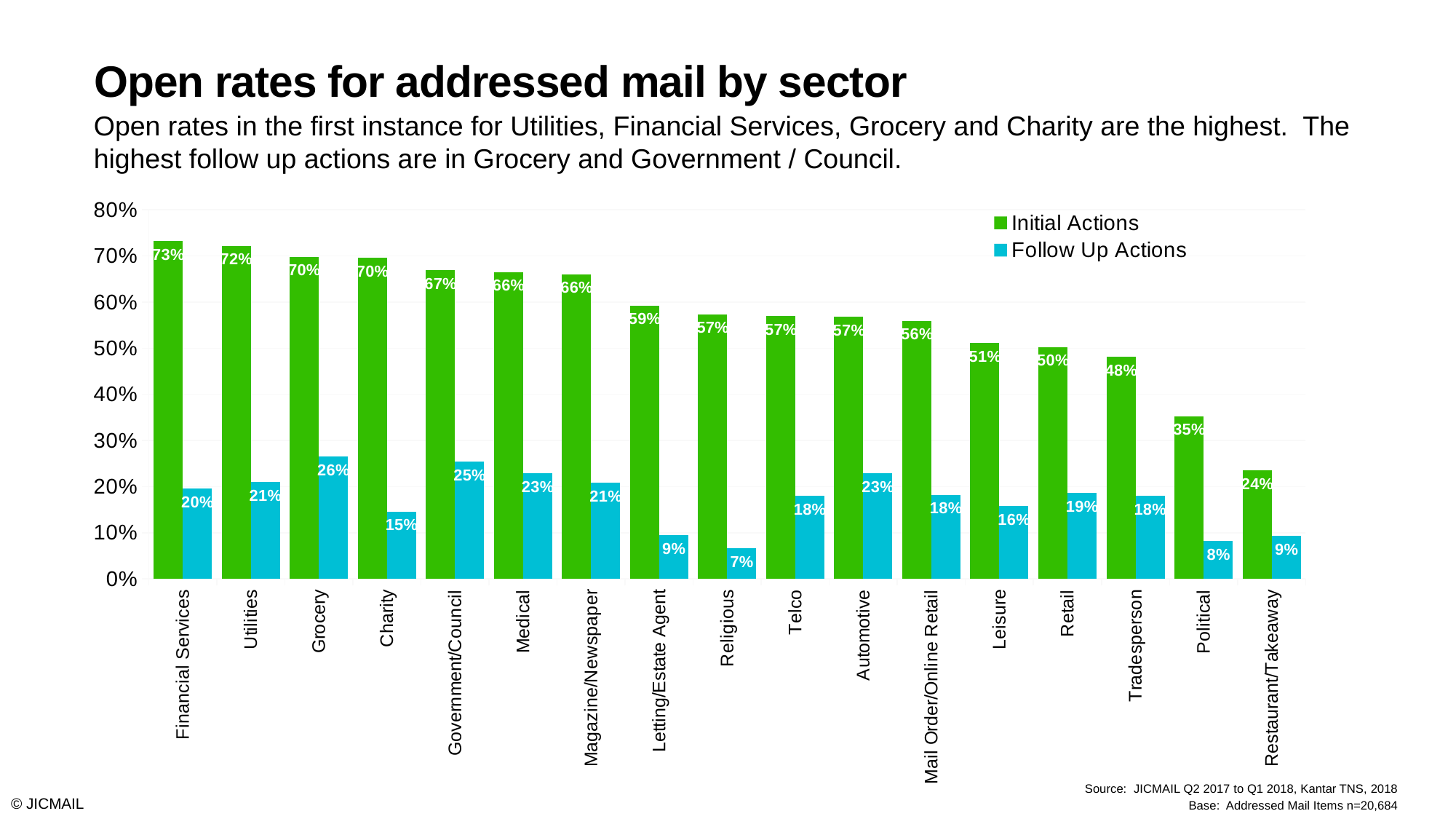
What is the Initial Actions value for Grocery? 70% Is the Initial Actions value for Tradesperson greater or less than 50%? less Which sector has the lowest Follow Up Actions value? Religious What is the difference between the Initial Actions and Follow Up Actions values for Financial Services? 53% What is the Follow Up Actions value for Government/Council? 25% What is the Initial Actions value for Political? 35% Which is larger, the Follow Up Actions value for Charity or for Medical? Medical Which sector has the lowest Initial Actions value? Restaurant/Takeaway What kind of chart is shown on the slide? Bar chart Which sector has the highest Follow Up Actions value? Grocery How many series does the legend list? 2 How many sectors are shown on the x axis? 17